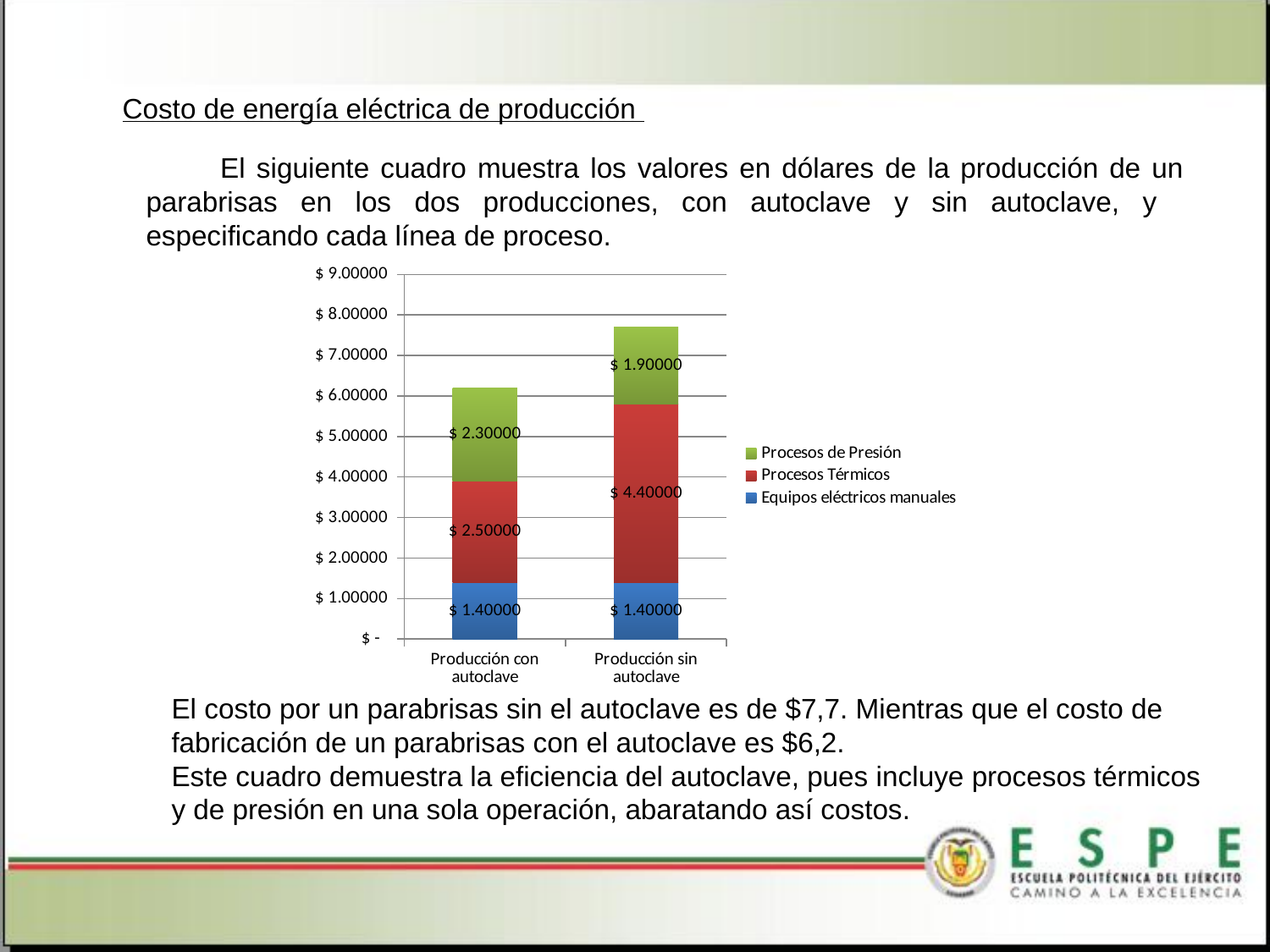
How many categories are shown on the x axis of the chart? 2 What is the value of Procesos Térmicos for Producción sin autoclave? $ 4.40000 What is the total of the stacked bar for Producción sin autoclave? $ 7.70000 What is the value of Equipos eléctricos manuales for Producción sin autoclave? $ 1.40000 What type of chart is shown on the slide? Stacked bar chart Which colour represents Procesos Térmicos in the chart? Red What is the total of the stacked bar for Producción con autoclave? $ 6.20000 How many series does the chart's legend list? 3 What is the difference in Procesos Térmicos between Producción sin autoclave and Producción con autoclave? $ 1.90000 Which category has the higher total cost, Producción con autoclave or Producción sin autoclave? Producción sin autoclave Which series is the largest segment in the Producción sin autoclave bar? Procesos Térmicos What is the value of Procesos de Presión for Producción con autoclave? $ 2.30000